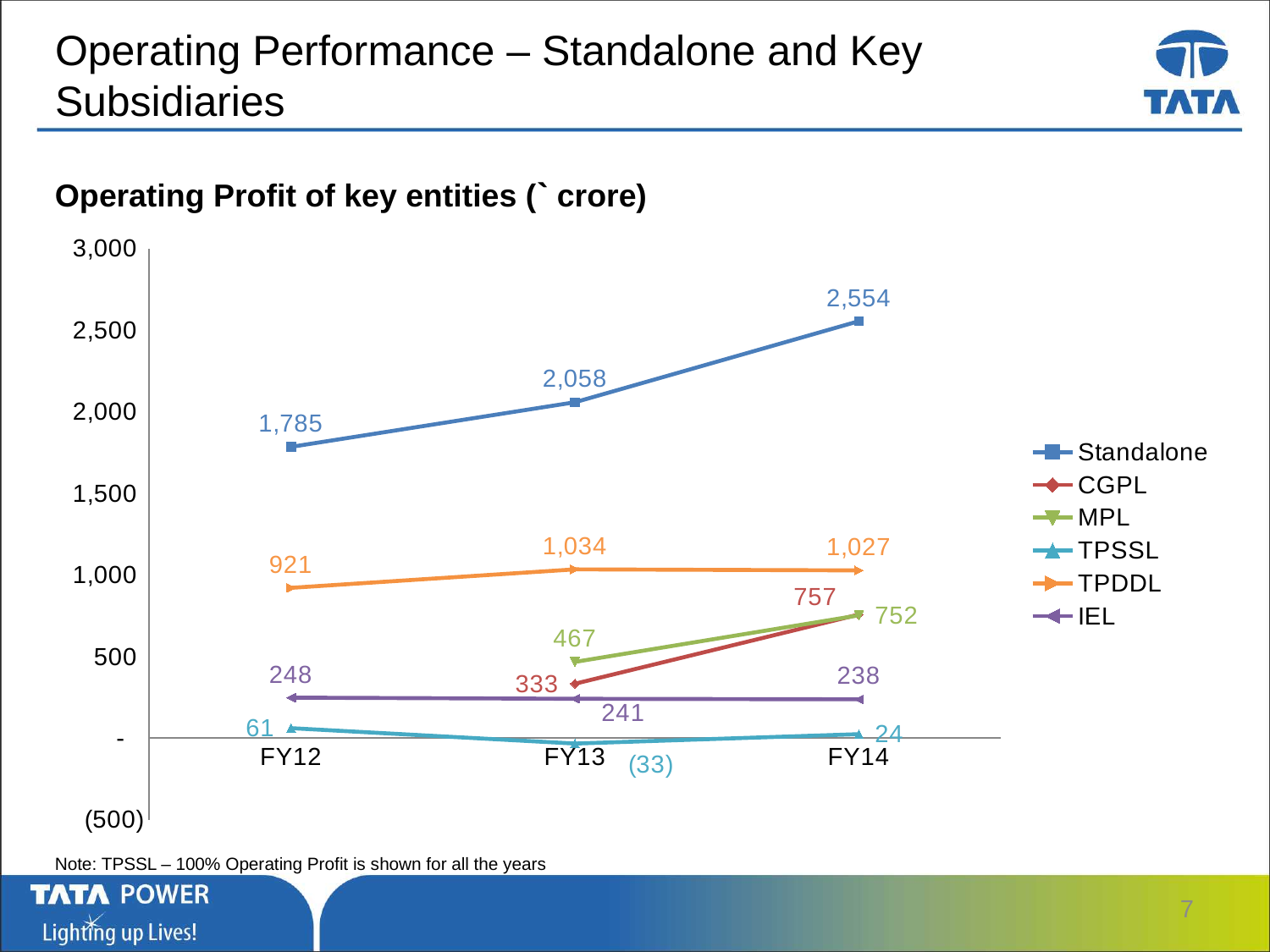
How many fiscal years are shown on the x axis? 3 Which is larger in FY13: the MPL value or the CGPL value? MPL Which entity has the highest operating profit in FY14? Standalone What is the TPDDL operating profit in FY13? 1,034 What type of chart is shown on the slide? Line chart Which entity has the lowest operating profit in FY12? TPSSL What is the Standalone operating profit in FY14? 2,554 What is the difference between the Standalone operating profit in FY14 and FY12? 769 Does the Standalone operating profit rise or fall from FY12 to FY14? Rise How many series does the legend list? 6 What is the CGPL operating profit in FY14? 757 What is the TPSSL value in FY13? (33)